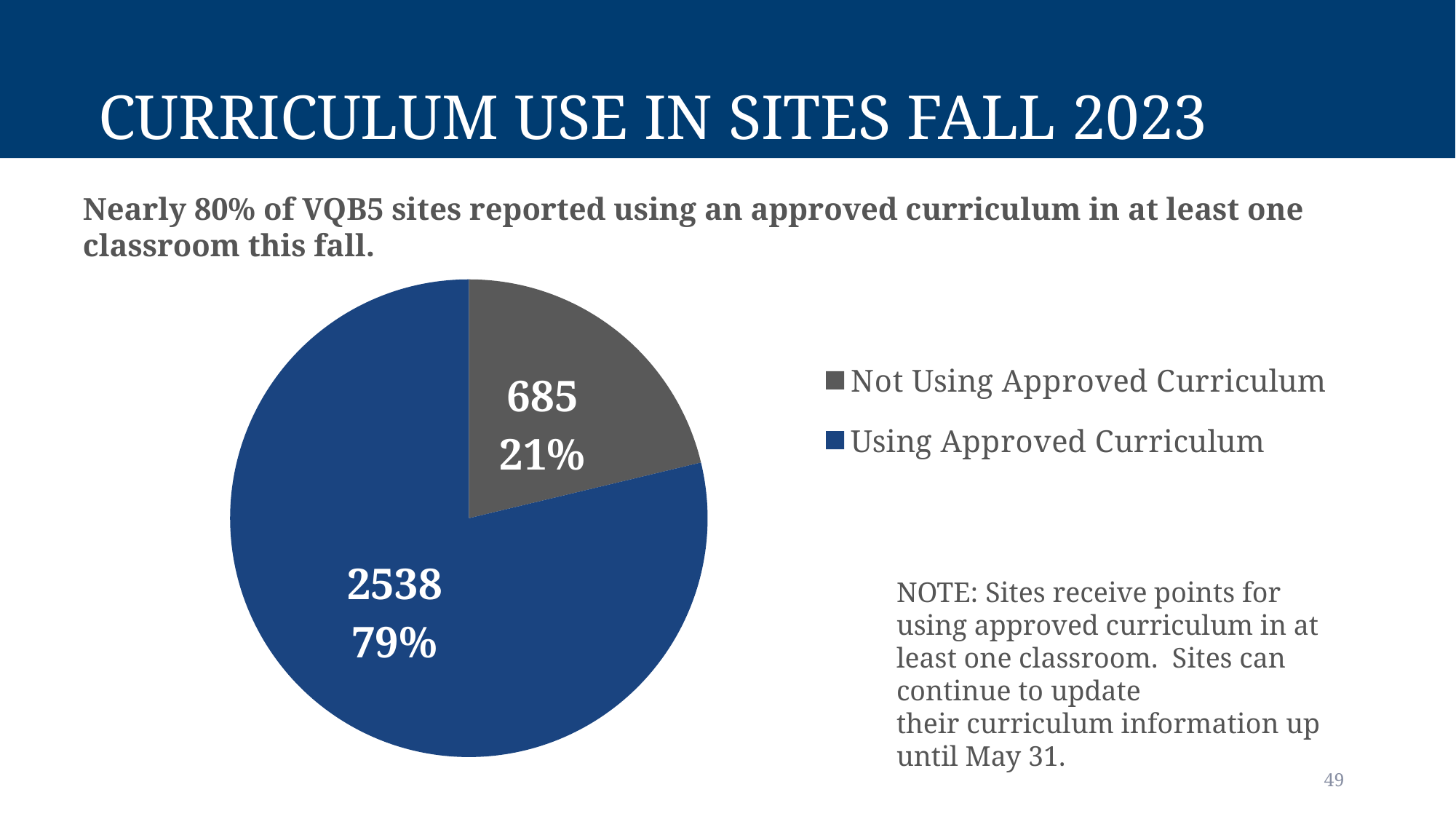
What colour is the Not Using Approved Curriculum slice? grey How many sites are in the Using Approved Curriculum slice? 2538 How many slices does the pie chart have? 2 What is the difference in number of sites between Using Approved Curriculum and Not Using Approved Curriculum? 1853 Which slice is the smallest? Not Using Approved Curriculum Which is larger, the Using Approved Curriculum slice or the Not Using Approved Curriculum slice? Using Approved Curriculum Which slice is the largest? Using Approved Curriculum How many sites are in the Not Using Approved Curriculum slice? 685 What share of the pie is Not Using Approved Curriculum? 21% What is the total number of sites across both slices? 3223 What share of the pie is Using Approved Curriculum? 79% What kind of chart is shown on the slide? pie chart